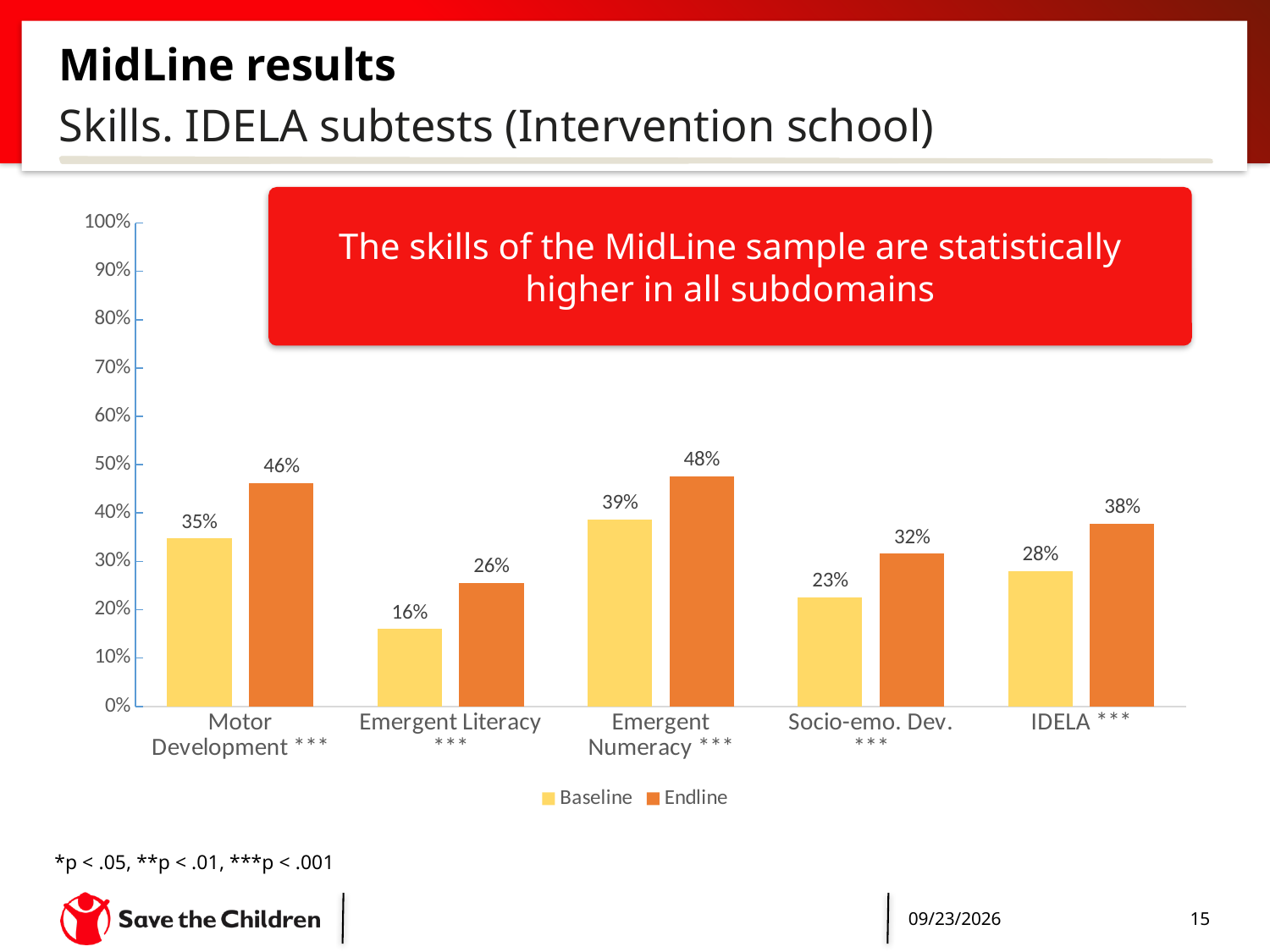
Which category has the lowest Baseline value? Emergent Literacy Which category has the highest Endline value? Emergent Numeracy How many categories are shown on the x axis? 5 How many series does the legend list? 2 What is the Baseline value for Emergent Literacy? 16% What is the difference between the Endline and Baseline values for Motor Development? 11% What is the Baseline value for IDELA? 28% What is the difference between the Endline and Baseline values for Socio-emo. Dev.? 9% What kind of chart is shown on the slide? Bar chart What is the Endline value for Emergent Numeracy? 48% Which is larger: the Baseline value for Emergent Numeracy or the Endline value for IDELA? Baseline value for Emergent Numeracy What are the two series named in the legend? Baseline and Endline